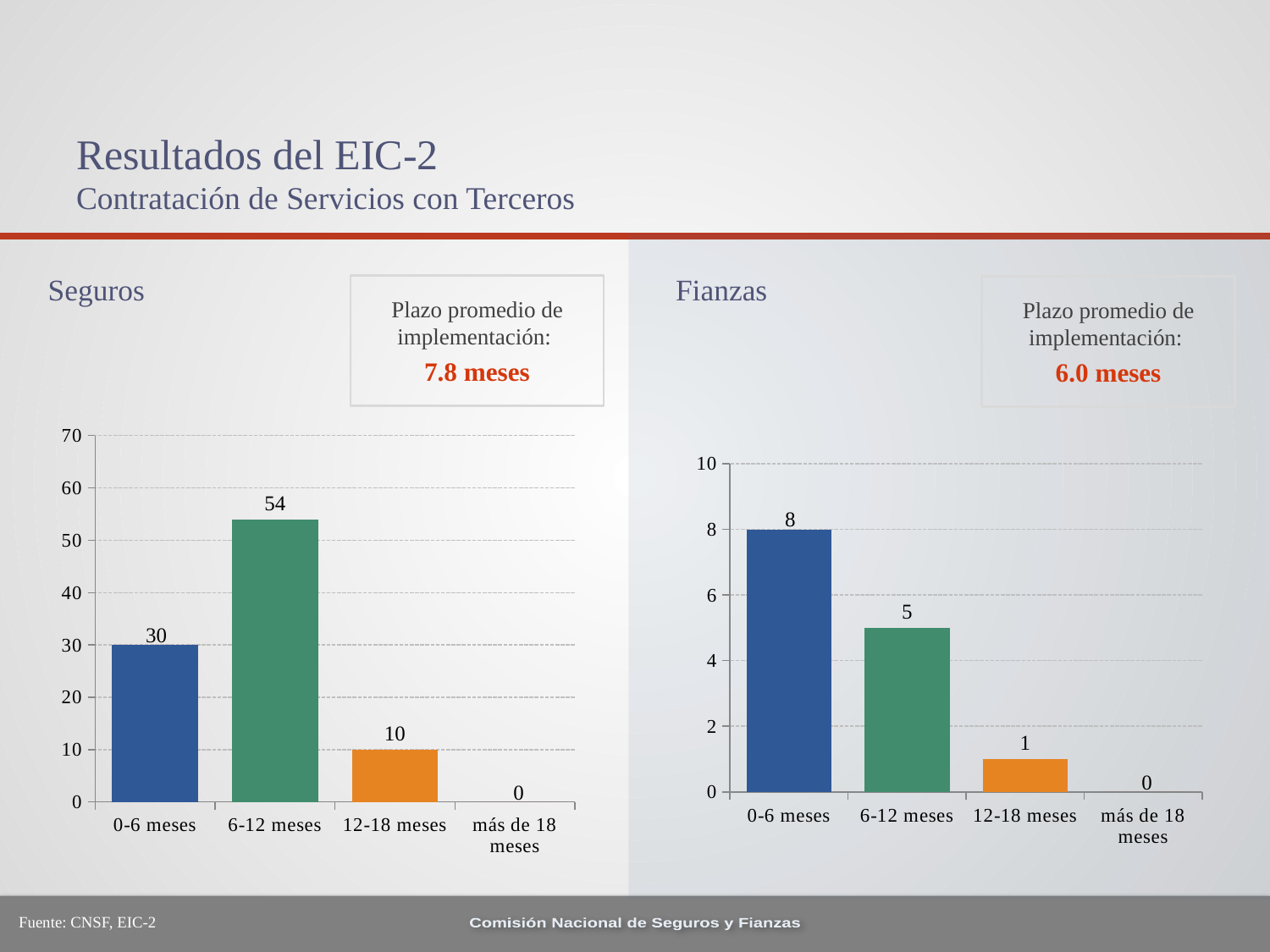
How many categories are shown on the x axis of the Fianzas chart? 4 What kind of chart is the Seguros chart? bar chart In the Fianzas chart, do the values rise or fall from 0-6 meses to más de 18 meses? fall In the Seguros chart, what is the difference between the values for 6-12 meses and 0-6 meses? 24 In the Fianzas chart, which category has the highest value? 0-6 meses In the Seguros chart, which is larger: the value for 0-6 meses or the value for 12-18 meses? 0-6 meses In the Seguros chart, what is the value for 6-12 meses? 54 In the Fianzas chart, what is the value for 12-18 meses? 1 In the Fianzas chart, what is the difference between the values for 0-6 meses and 6-12 meses? 3 What is the average implementation period (plazo promedio de implementación) shown for Fianzas? 6.0 meses In the Seguros chart, which category has the lowest value? más de 18 meses In the Seguros chart, what is the value for 0-6 meses? 30